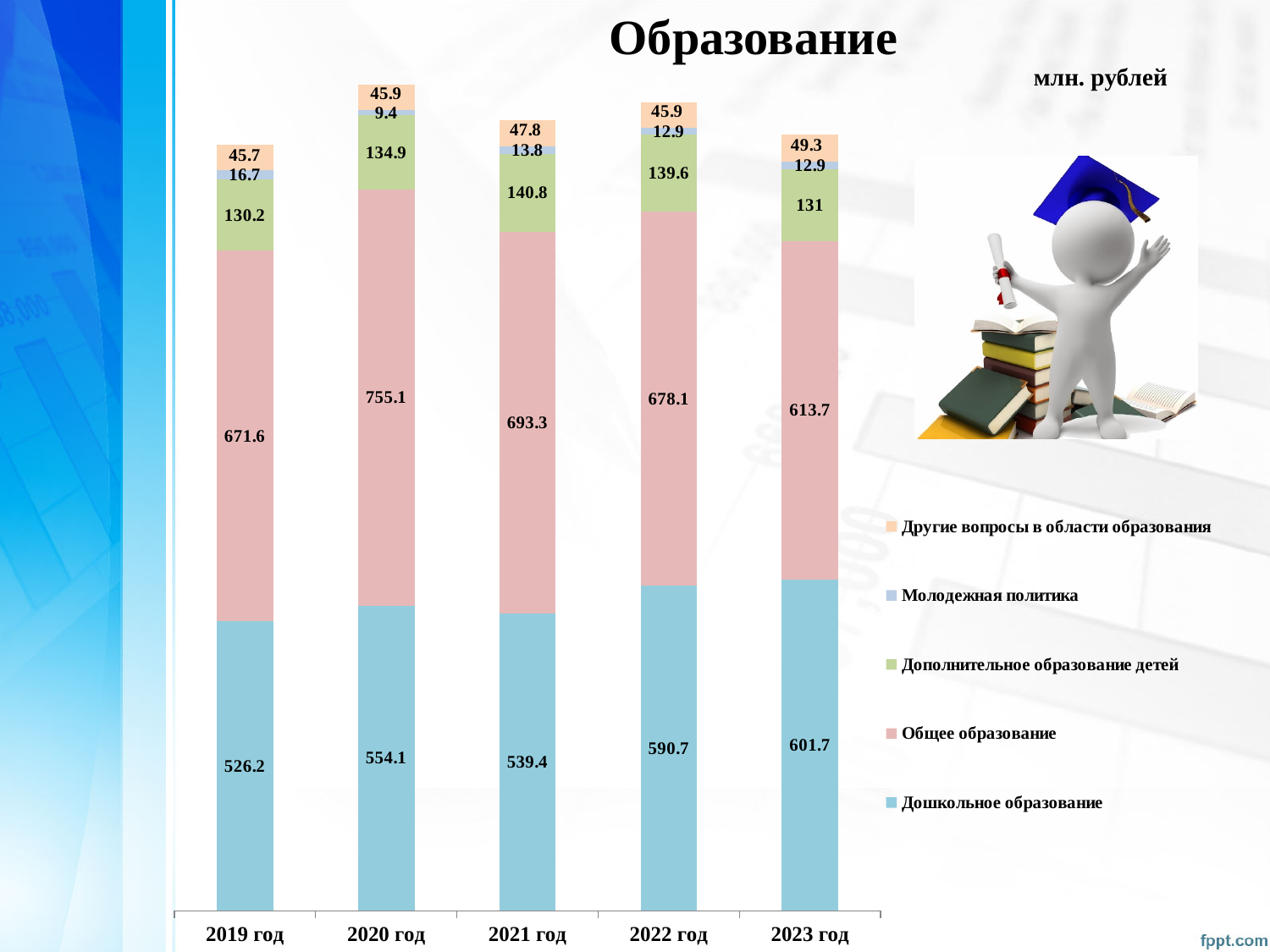
What unit is stated for the values on the chart? млн. рублей What is the total of the stacked bar for 2019 год? 1390.4 How many years (categories) are shown on the x axis? 5 What kind of chart is shown on the slide? stacked bar chart What is the difference between Дошкольное образование in 2023 год and in 2019 год? 75.5 What is the value for Молодежная политика in 2019 год? 16.7 What is the value for Общее образование in 2020 год? 755.1 In which year is the value for Молодежная политика the lowest? 2020 год Which is larger in 2023 год: Дошкольное образование or Общее образование? Общее образование How many series does the legend list? 5 What is the value for Дошкольное образование in 2023 год? 601.7 In which year is the value for Общее образование the highest? 2020 год